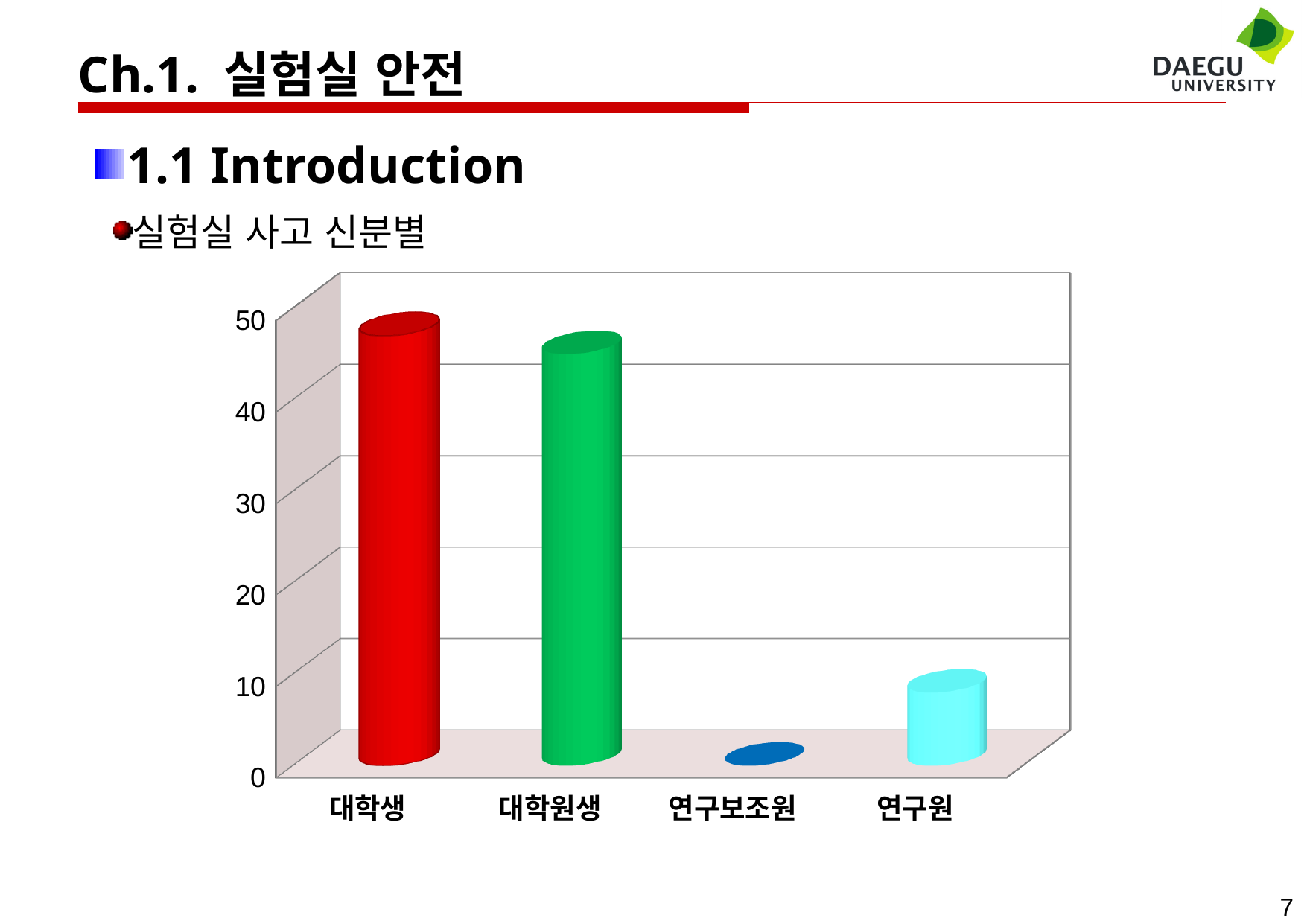
Is the value for 연구보조원 greater or less than 10? less Is the value for 대학원생 greater or less than 30? greater What kind of chart is shown on the slide? bar chart Which is larger, the value for 연구원 or the value for 연구보조원? 연구원 Is the value for 대학생 greater or less than 40? greater Which category has the lowest value in the chart? 연구보조원 Which is larger, the value for 대학원생 or the value for 연구원? 대학원생 Which category has the highest value in the chart? 대학생 What is the heading given above the chart? 실험실 사고 신분별 What colour is the bar for 대학생? red How many categories are shown on the x axis of the chart? 4